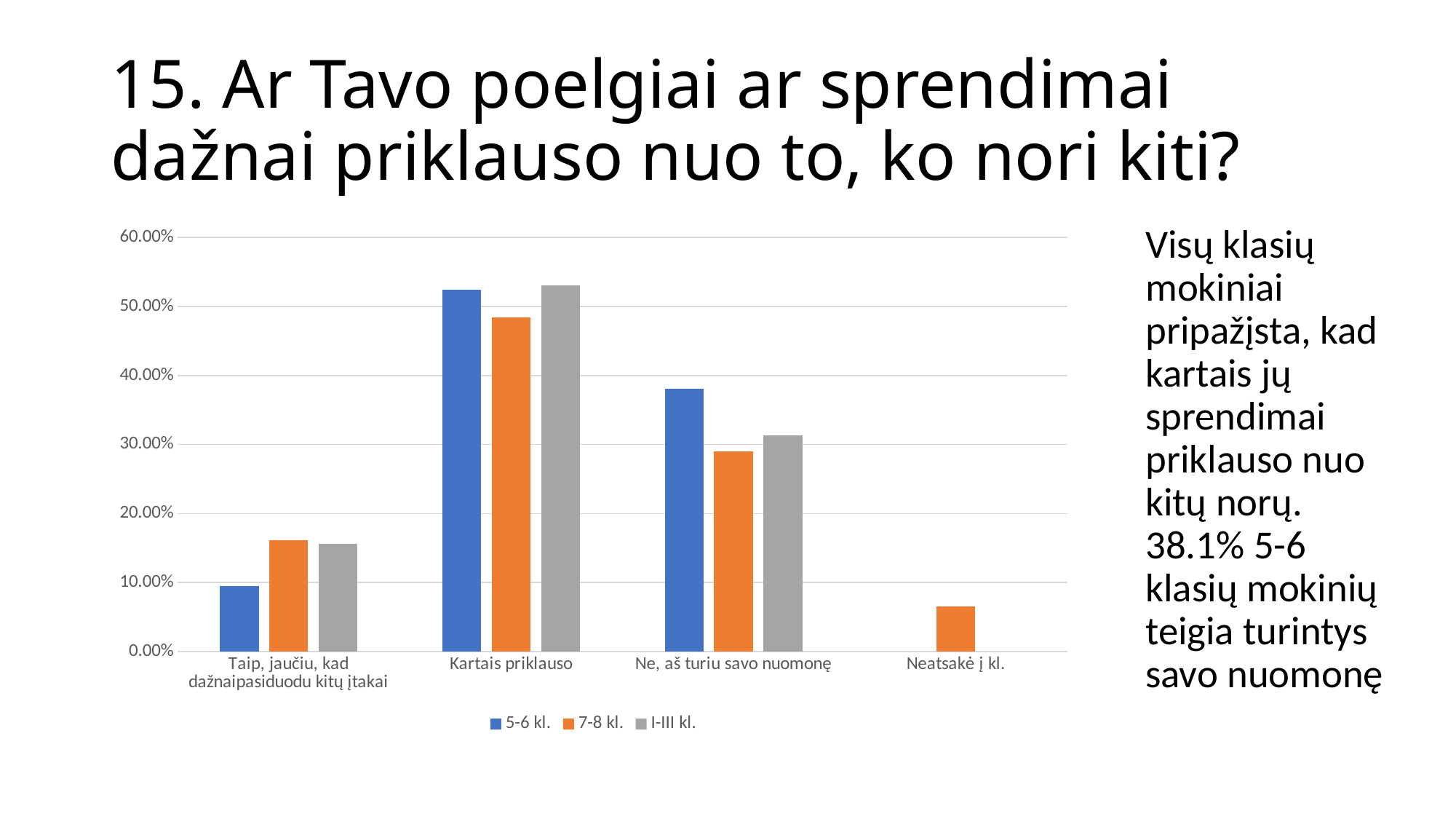
Which series is shown in orange in the chart's legend? 7-8 kl. In the category "Kartais priklauso", which is larger: the value for 7-8 kl. or for I-III kl.? I-III kl. Is the value for 7-8 kl. in the category "Taip, jaučiu, kad dažnai pasiduodu kitų įtakai" greater or less than 10.00%? greater Is the value for 5-6 kl. in the category "Ne, aš turiu savo nuomonę" greater or less than 40.00%? less Is the value for 7-8 kl. in the category "Neatsakė į kl." greater or less than 10.00%? less Which category has the highest value for the 7-8 kl. series? Kartais priklauso How many series does the chart's legend list? 3 What kind of chart is shown on the slide? bar chart How many categories are shown on the x axis of the chart? 4 In the category "Ne, aš turiu savo nuomonę", which is larger: the value for 5-6 kl. or for 7-8 kl.? 5-6 kl.